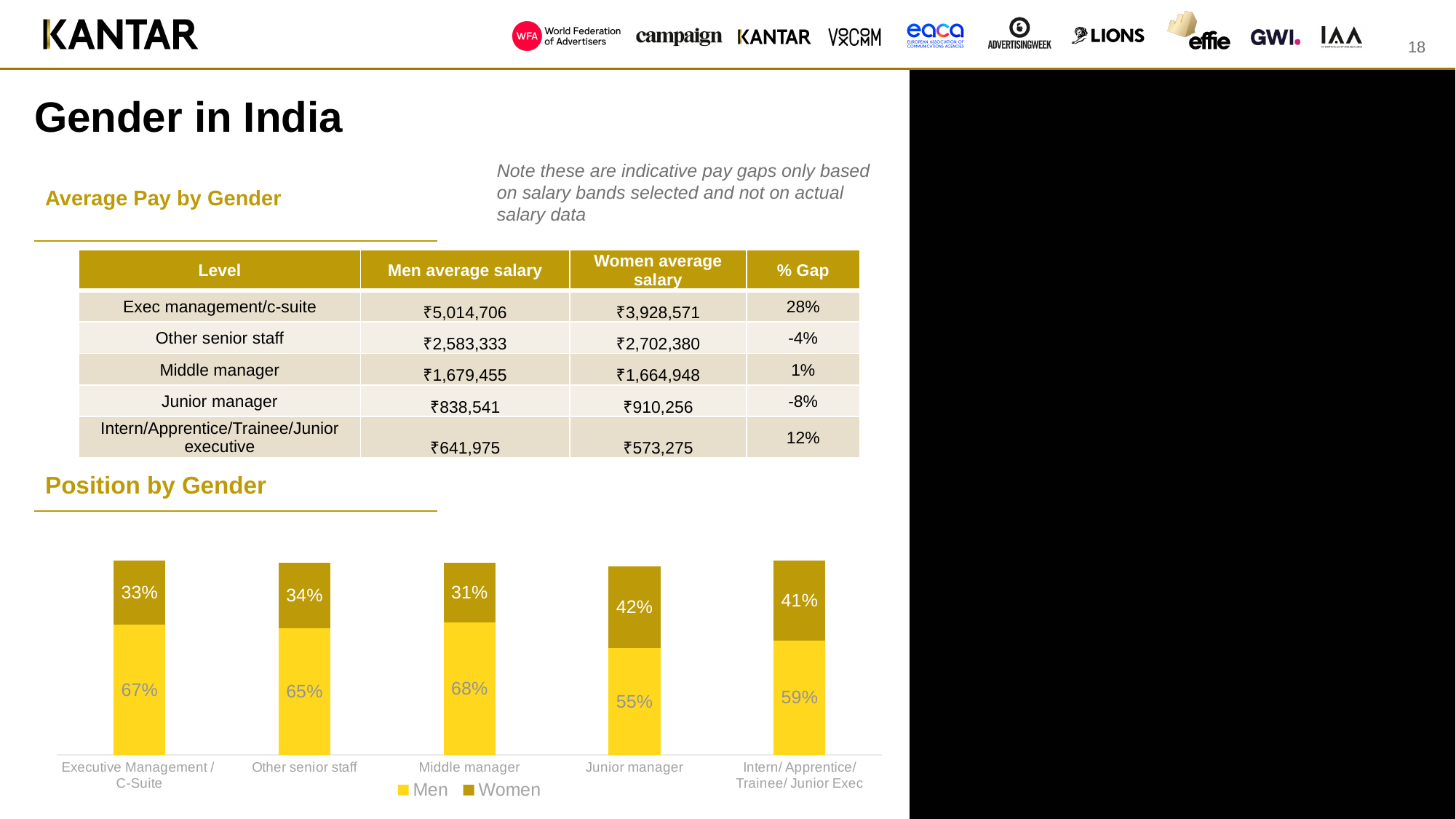
What kind of chart is the Position by Gender chart? Stacked bar chart In the Position by Gender chart, what is the Women share for Intern/ Apprentice/ Trainee/ Junior Exec? 41% How many series does the legend of the Position by Gender chart list? 2 In the Position by Gender chart, which level has the highest Women share? Junior manager In the Position by Gender chart, what is the Women share for Middle manager? 31% What are the legend entries in the Position by Gender chart? Men, Women In the Position by Gender chart, which level has the highest Men share? Middle manager In the Position by Gender chart, what is the difference between the Men and Women shares for Executive Management / C-Suite? 34 percentage points In the Position by Gender chart, which level has the lowest Women share? Middle manager In the Position by Gender chart, is the Men share larger for Other senior staff or for Intern/ Apprentice/ Trainee/ Junior Exec? Other senior staff In the Position by Gender chart, what percentage of Junior managers are men? 55% How many levels are shown on the x axis of the Position by Gender chart? 5